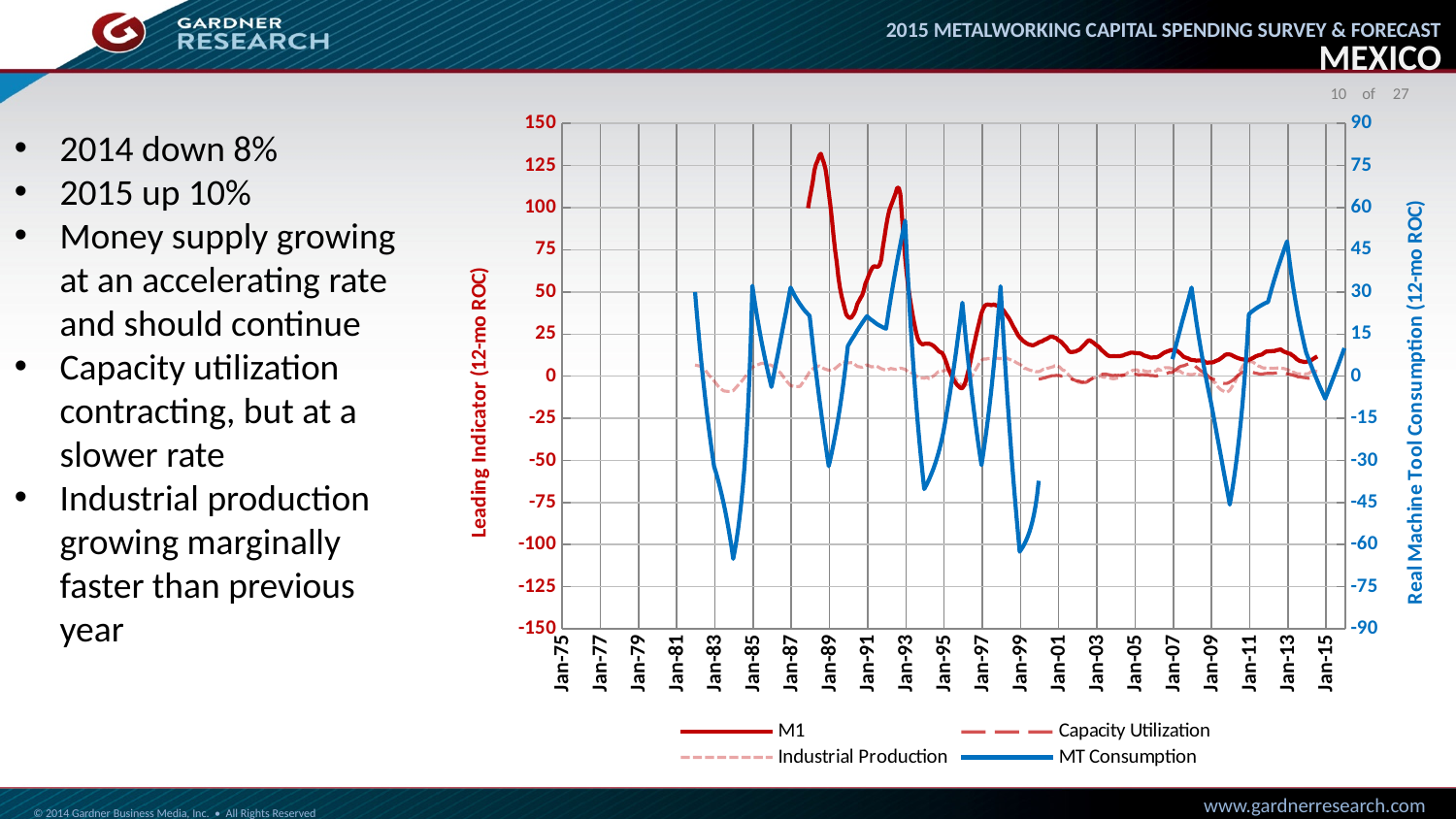
Does the M1 line rise or fall between Jan-89 and Jan-91? Fall How many series does the chart legend list? 4 Does the MT Consumption line rise or fall between Jan-09 and Jan-13? Rise What is the title of the left vertical axis? Leading Indicator (12-mo ROC) What is the first date label on the x axis? Jan-75 What kind of chart is shown on the slide? Line chart How many date labels are shown along the x axis? 21 Which series are listed in the chart legend? M1, Capacity Utilization, Industrial Production, MT Consumption What is the highest value shown on the left vertical axis? 150 Is the peak value of the M1 line around Jan-89 greater or less than 100 on the left axis? greater What is the lowest value shown on the right vertical axis? -90 Which series reaches the highest point on the chart? M1